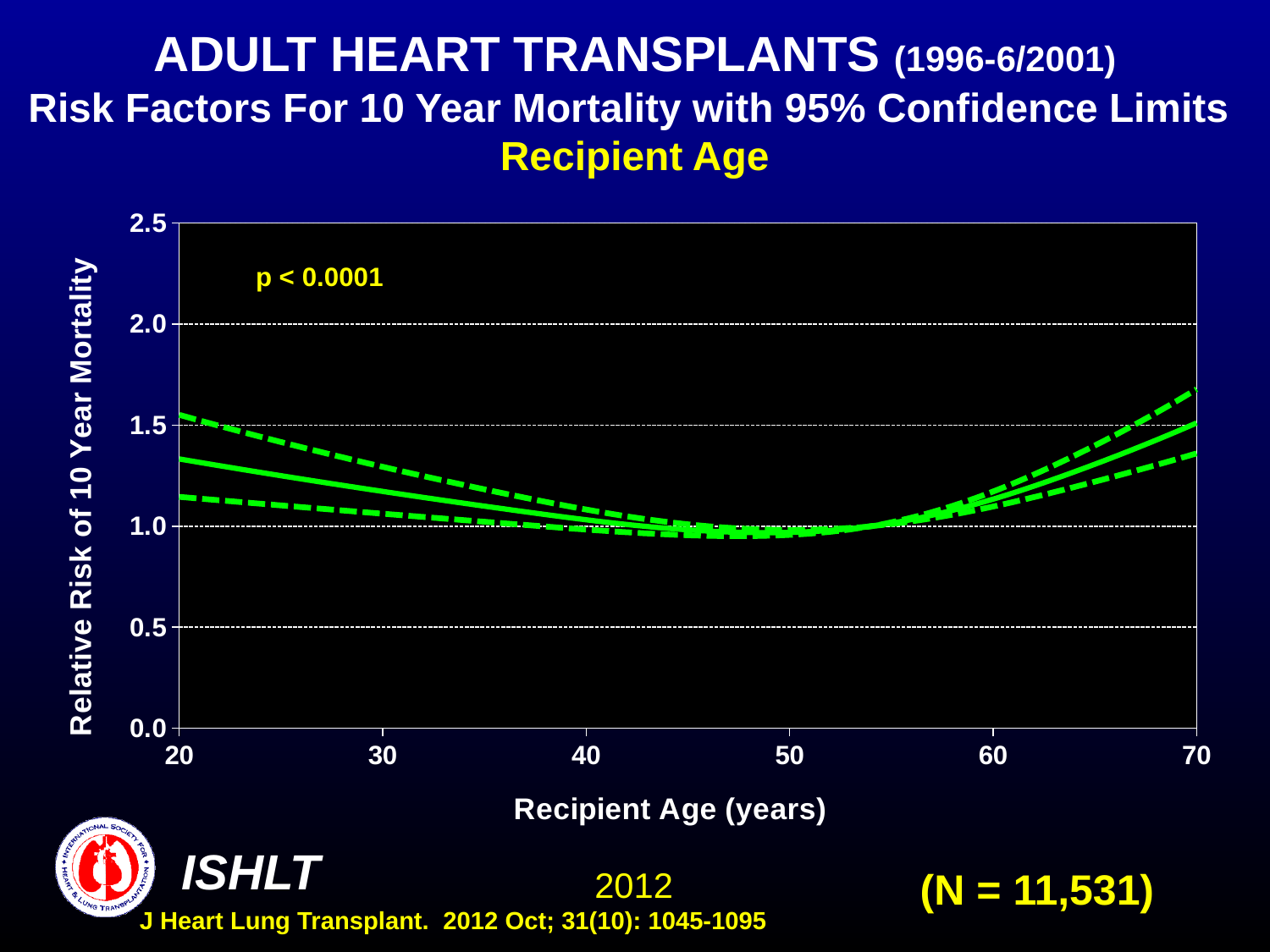
Is the lower confidence limit (lower dashed line) at recipient age 20 greater or less than 1.5? less Is the relative risk (solid line) at recipient age 20 greater or less than 1.0? greater Is the relative risk (solid line) at recipient age 70 greater or less than 1.0? greater What is the sample size (N) shown on the slide? N = 11,531 Does the relative risk (solid line) rise or fall as recipient age increases from 20 to 50? fall What kind of chart is shown on the slide? line chart How many lines are plotted on the chart? 3 What is the p-value printed on the chart? p < 0.0001 Does the relative risk (solid line) rise or fall as recipient age increases from 50 to 70? rise